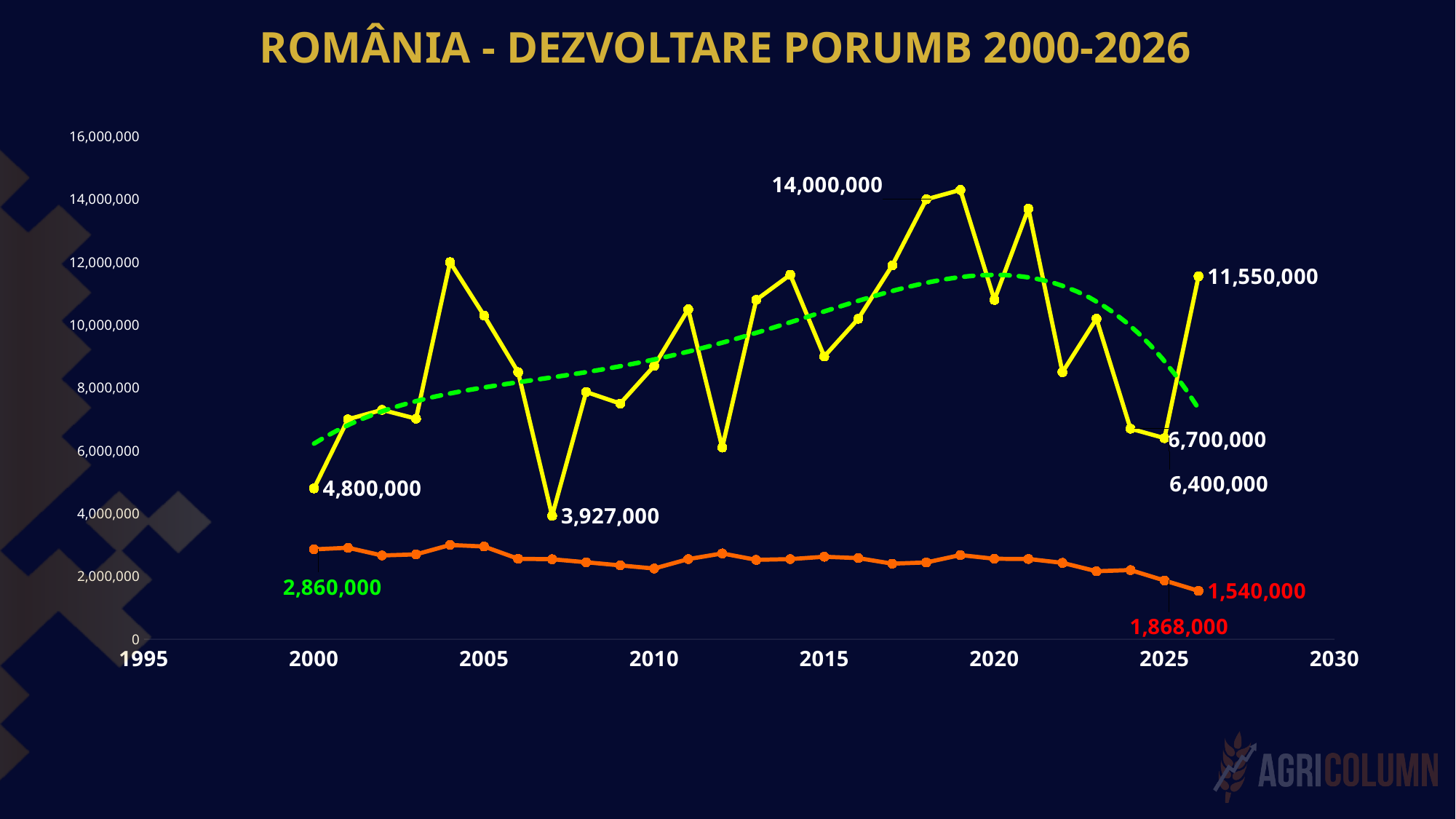
What kind of chart is shown on the slide? line chart Is the value of the yellow line in 2004 greater or less than 10,000,000? greater What is the value of the yellow line in 2007? 3,927,000 What is the value of the yellow line in 2026? 11,550,000 What is the value of the orange line in 2026? 1,540,000 What is the difference between the orange line's value in 2000 and in 2026? 1,320,000 What is the value of the yellow line in 2000? 4,800,000 Does the orange line overall rise or fall from 2000 to 2026? fall Which year has the larger value on the yellow line, 2000 or 2007? 2000 In which year does the yellow line reach its lowest value? 2007 By how much does the yellow line's value in 2026 exceed its value in 2000? 6,750,000 What is the value of the orange line in 2000? 2,860,000